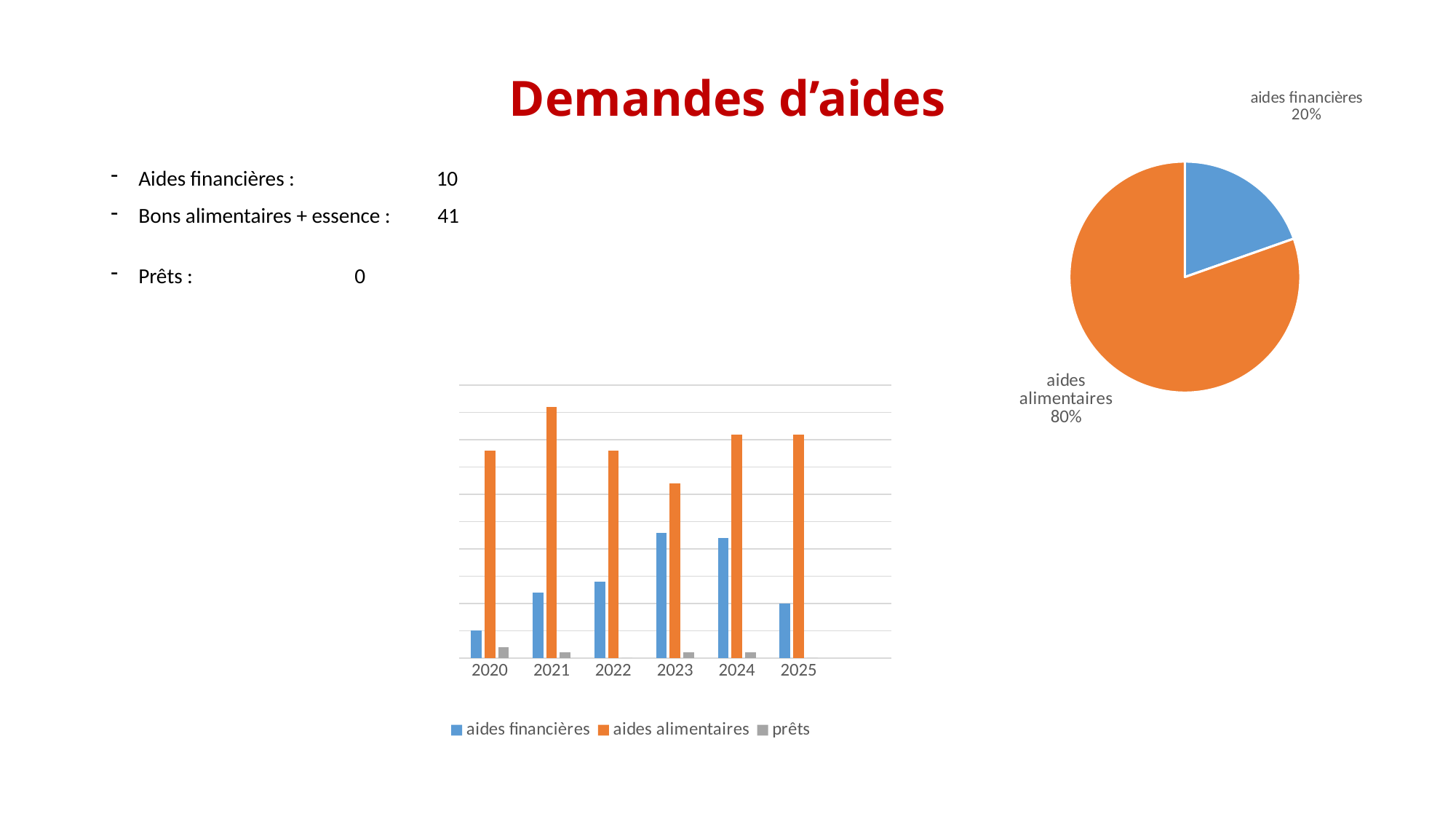
What kind of chart is the chart at the bottom centre of the slide? bar chart In the bar chart, is the value for aides alimentaires larger in 2021 or in 2022? 2021 In the pie chart, what share is labelled for aides financières? 20% In the bar chart, do the values for aides financières rise or fall from 2020 to 2023? rise What kind of chart is the chart at the top right of the slide? pie chart In the bar chart, how many series does the legend list? 3 In the bar chart, which year has the lowest value for aides alimentaires? 2023 In the bar chart, which year has the highest value for aides alimentaires? 2021 In the pie chart, what share is labelled for aides alimentaires? 80% In the bar chart, which year has the lowest value for aides financières? 2020 In the bar chart, how many years are shown on the x axis? 6 In the bar chart, is the value for aides financières larger in 2020 or in 2025? 2025